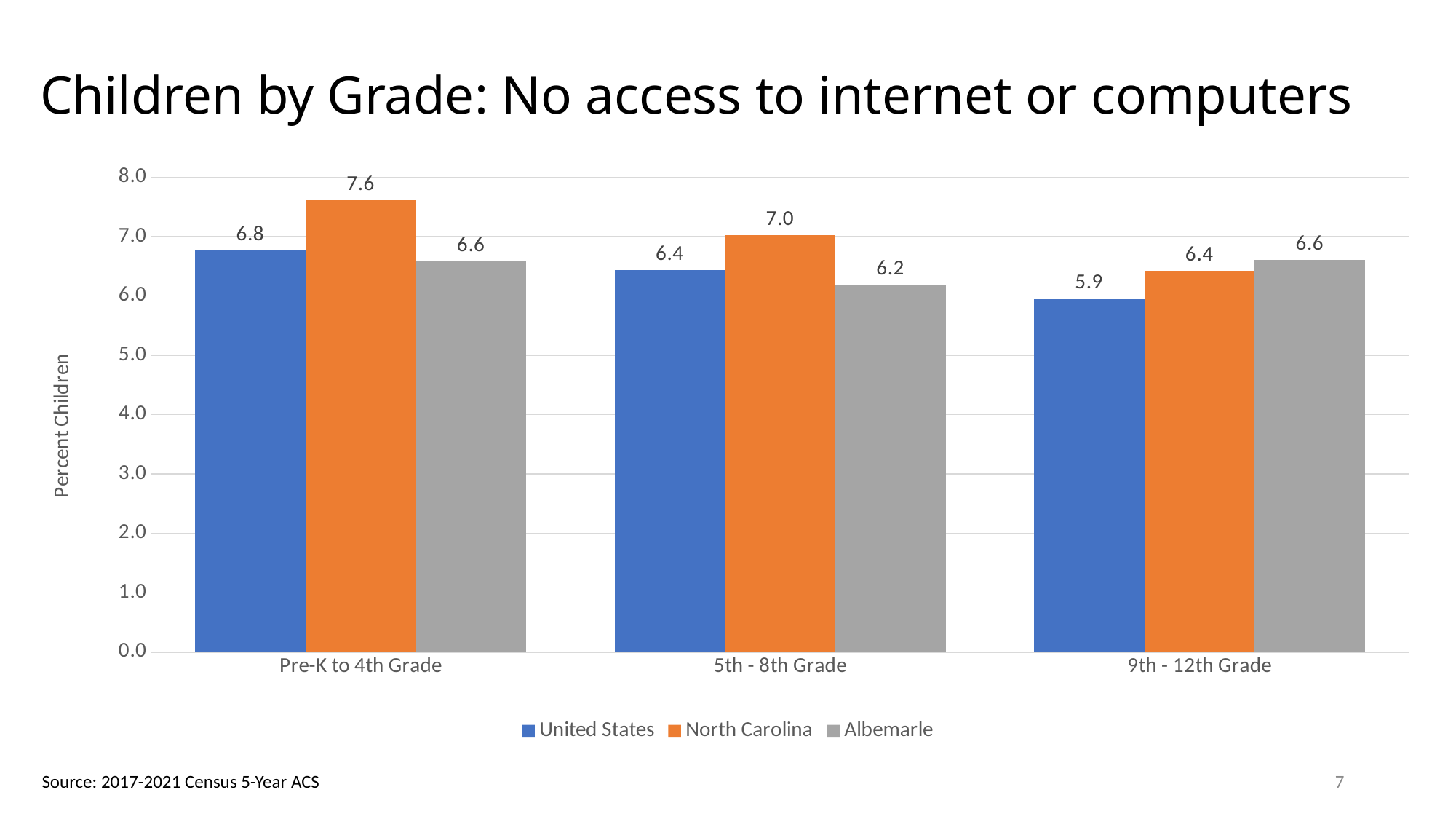
What is the value for North Carolina in the Pre-K to 4th Grade category? 7.6 Which grade category has the highest value for North Carolina? Pre-K to 4th Grade How many series does the legend list? 3 What kind of chart is shown on the slide? Bar chart What is the value for Albemarle in the 5th - 8th Grade category? 6.2 Which is larger in the 9th - 12th Grade category, the Albemarle value or the United States value? Albemarle How many grade categories are shown on the x axis? 3 What is the value for United States in the 9th - 12th Grade category? 5.9 Do the United States values rise or fall from Pre-K to 4th Grade to 9th - 12th Grade? Fall What is the label of the y axis? Percent Children Which grade category has the lowest value for United States? 9th - 12th Grade What is the difference between the North Carolina and United States values for Pre-K to 4th Grade? 0.8